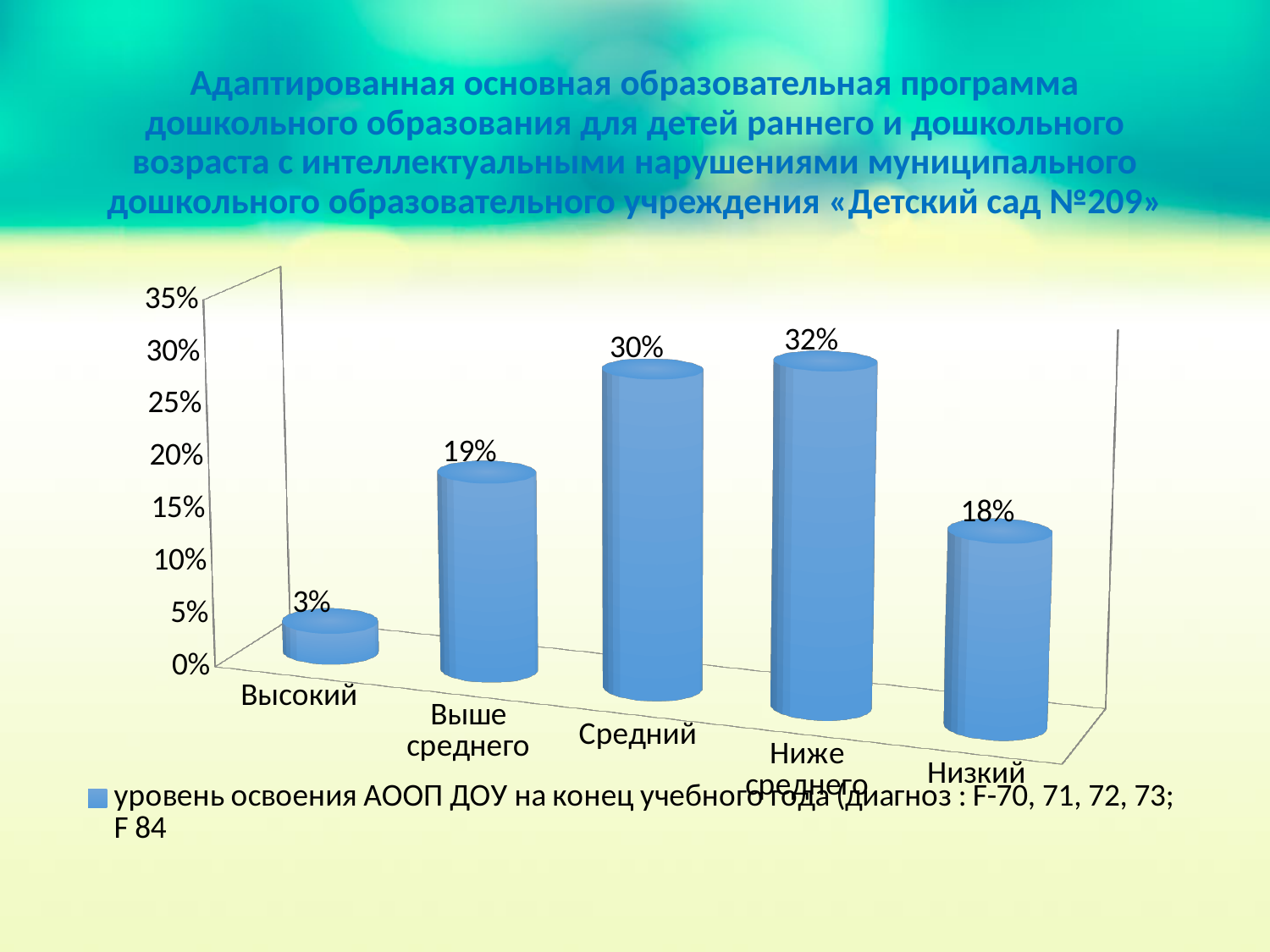
What is the difference between the values for Ниже среднего and Средний? 2% What is the value for the Низкий category? 18% What is the value for the Средний category? 30% How many categories are shown on the x axis? 5 What is the difference between the values for Выше среднего and Высокий? 16% Which category has the highest value? Ниже среднего How many series does the legend list? 1 What kind of chart is shown on the slide? bar chart What is the value for the Высокий category? 3% Which category has the lowest value? Высокий Which is larger, the value for Выше среднего or the value for Низкий? Выше среднего What is the value for the Выше среднего category? 19%